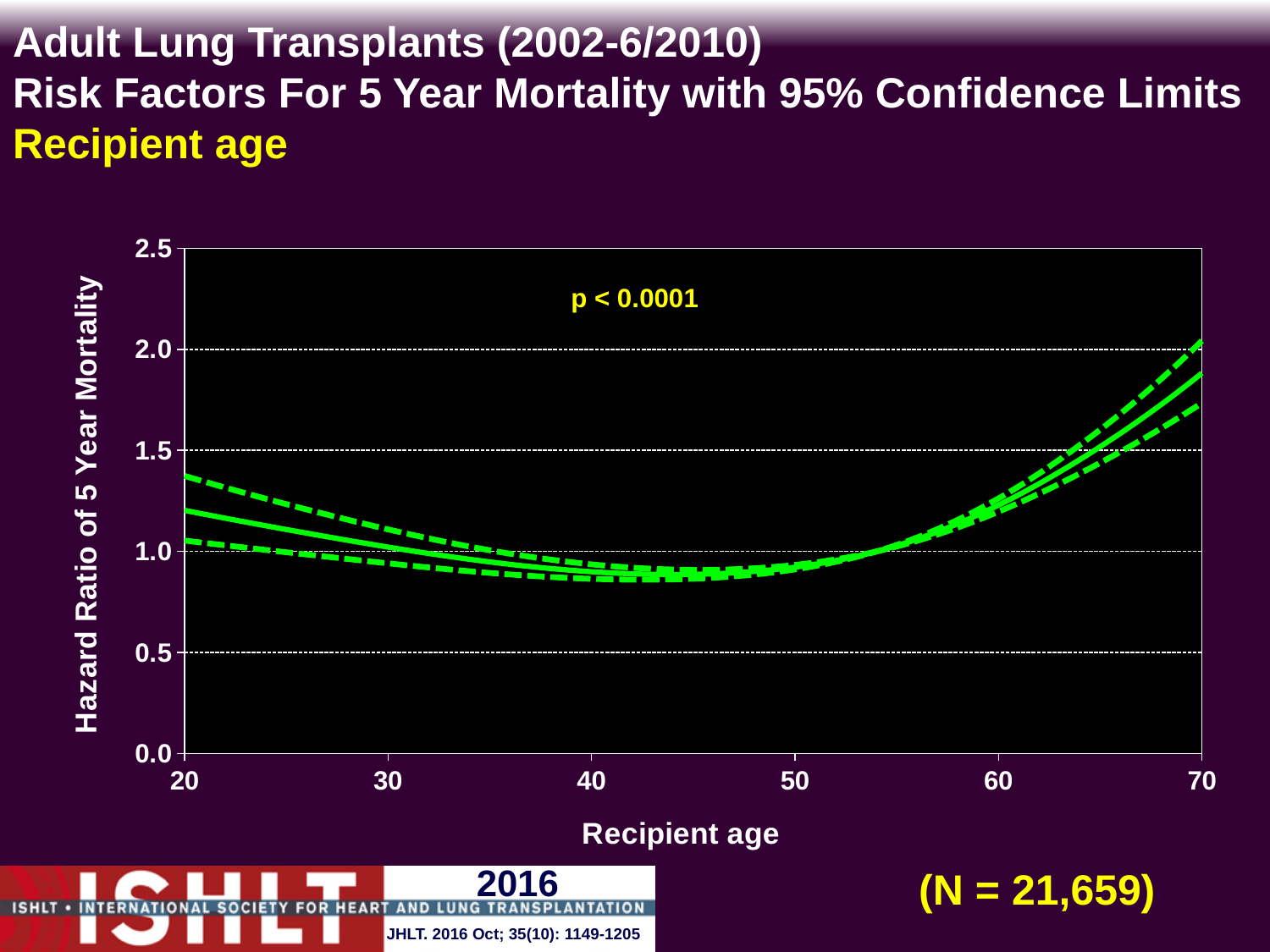
What is the highest value shown on the y axis of the chart? 2.5 What kind of chart is shown on the slide? line chart Does the solid hazard ratio line rise or fall as recipient age increases from 20 to 45? fall Is the hazard ratio shown by the solid line at recipient age 70 greater or less than 1.5? greater How many lines are plotted on the chart? 3 Is the hazard ratio shown by the solid line at recipient age 20 greater or less than 1.0? greater Is the hazard ratio shown by the solid line at recipient age 60 greater or less than 1.5? less What is the label of the y axis? Hazard Ratio of 5 Year Mortality Does the solid hazard ratio line rise or fall as recipient age increases from 50 to 70? rise Which is larger, the hazard ratio on the solid line at recipient age 70 or at recipient age 20? recipient age 70 What is the label of the x axis? Recipient age